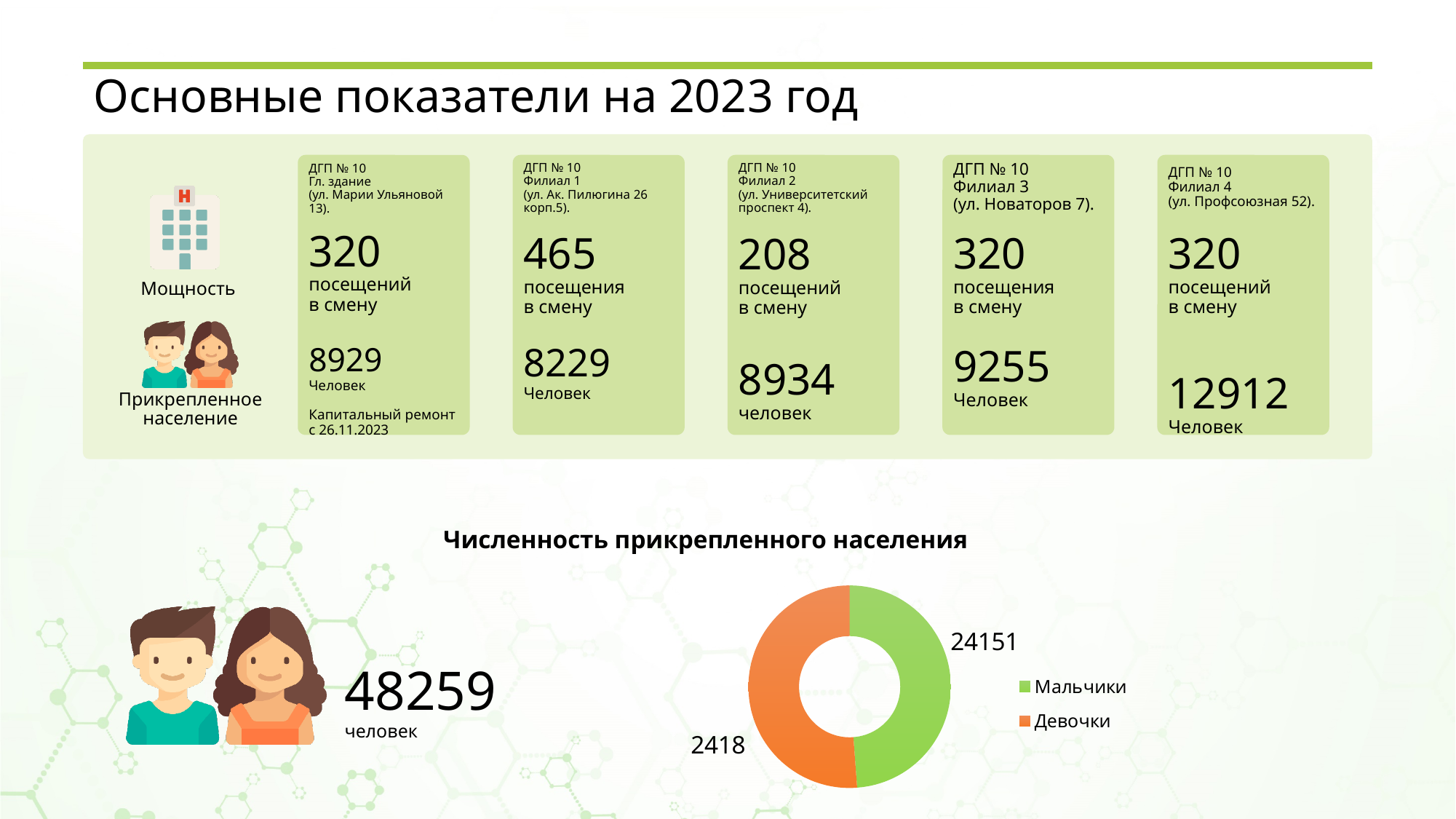
What kind of chart is shown under the title "Численность прикрепленного населения"? Pie chart (donut) How many slices does the donut chart have? 2 How many categories does the legend of the chart list? 2 Which legend entry is shown in green in the chart? Мальчики Which category in the chart is represented by the orange slice? Девочки What value is labelled for the "Мальчики" slice of the chart? 24151 What is the title of the chart on the slide? Численность прикрепленного населения